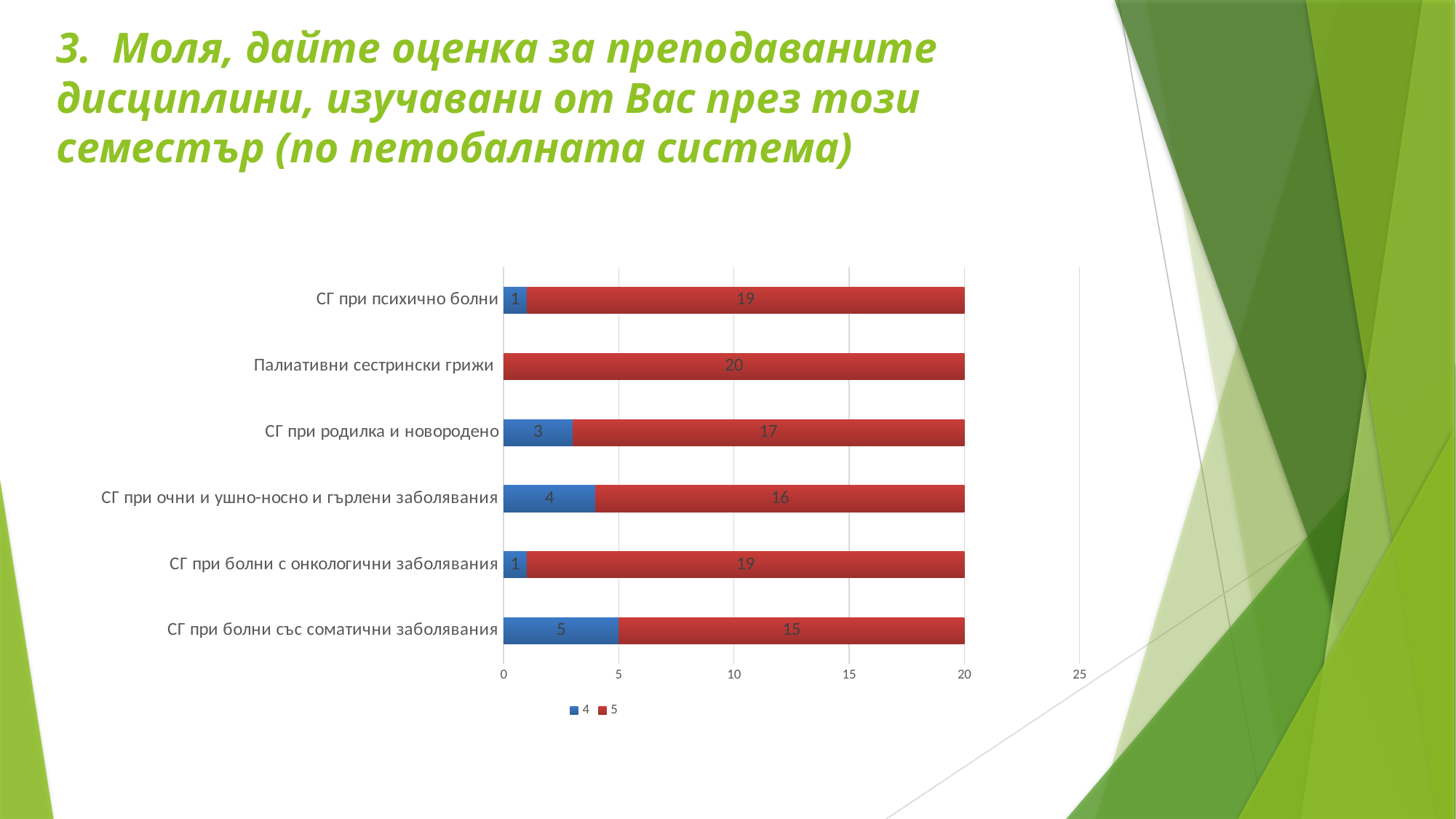
Which is larger: the series "4" value for "СГ при родилка и новородено" or for "СГ при очни и ушно-носно и гърлени заболявания"? СГ при очни и ушно-носно и гърлени заболявания Which category has the lowest value for series "5"? СГ при болни със соматични заболявания How many categories (disciplines) are shown on the chart? 6 What is the difference between the series "5" values for "СГ при психично болни" and "СГ при очни и ушно-носно и гърлени заболявания"? 3 Which category has the highest value for series "4"? СГ при болни със соматични заболявания How many series does the legend list? 2 What type of chart is shown on the slide? Stacked bar chart What colour represents series "5" in the chart? Red What is the value of series "5" for "СГ при родилка и новородено"? 17 What is the value of series "4" for "СГ при болни със соматични заболявания"? 5 What is the value of series "5" for "Палиативни сестрински грижи"? 20 What is the total of the stacked bar for "СГ при болни с онкологични заболявания"? 20